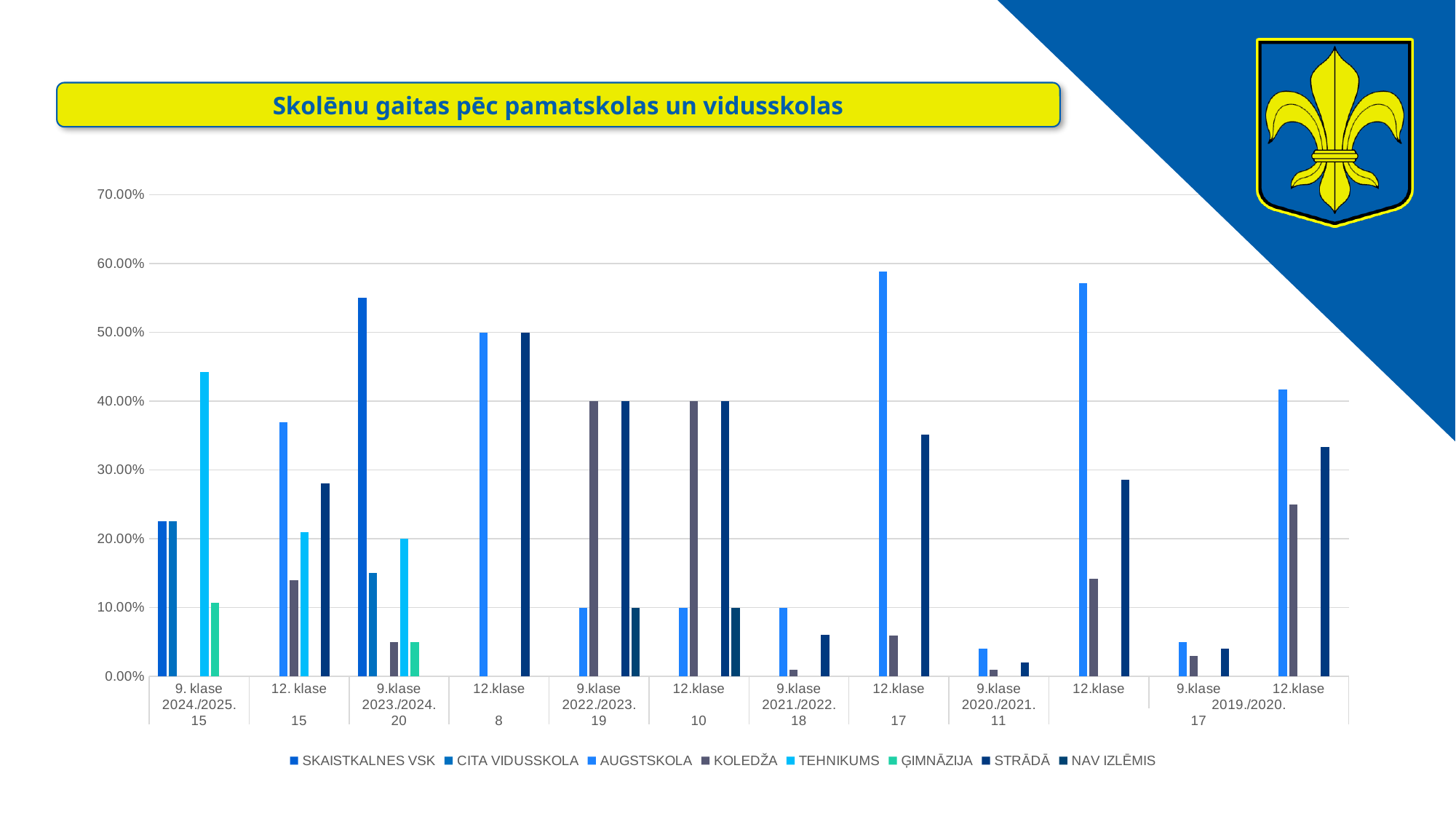
How many series does the legend list? 8 What kind of chart is shown on the slide? bar chart How many category groups are shown along the x axis? 12 In the 9.klase 2022./2023. group, which is larger: KOLEDŽA or AUGSTSKOLA? KOLEDŽA Which series is listed first in the legend? SKAISTKALNES VSK Is the value for AUGSTSKOLA in the 12.klase 2021./2022. group greater or less than 50.00%? greater In the 12.klase 2019./2020. group, which is larger: AUGSTSKOLA or KOLEDŽA? AUGSTSKOLA Which series has the highest value in the 12.klase 2020./2021. group? AUGSTSKOLA Is the value for STRĀDĀ in the 12. klase 2024./2025. group greater or less than 20.00%? greater Is the value for TEHNIKUMS in the 9. klase 2024./2025. group greater or less than 40.00%? greater What is the title of the chart? Skolēnu gaitas pēc pamatskolas un vidusskolas